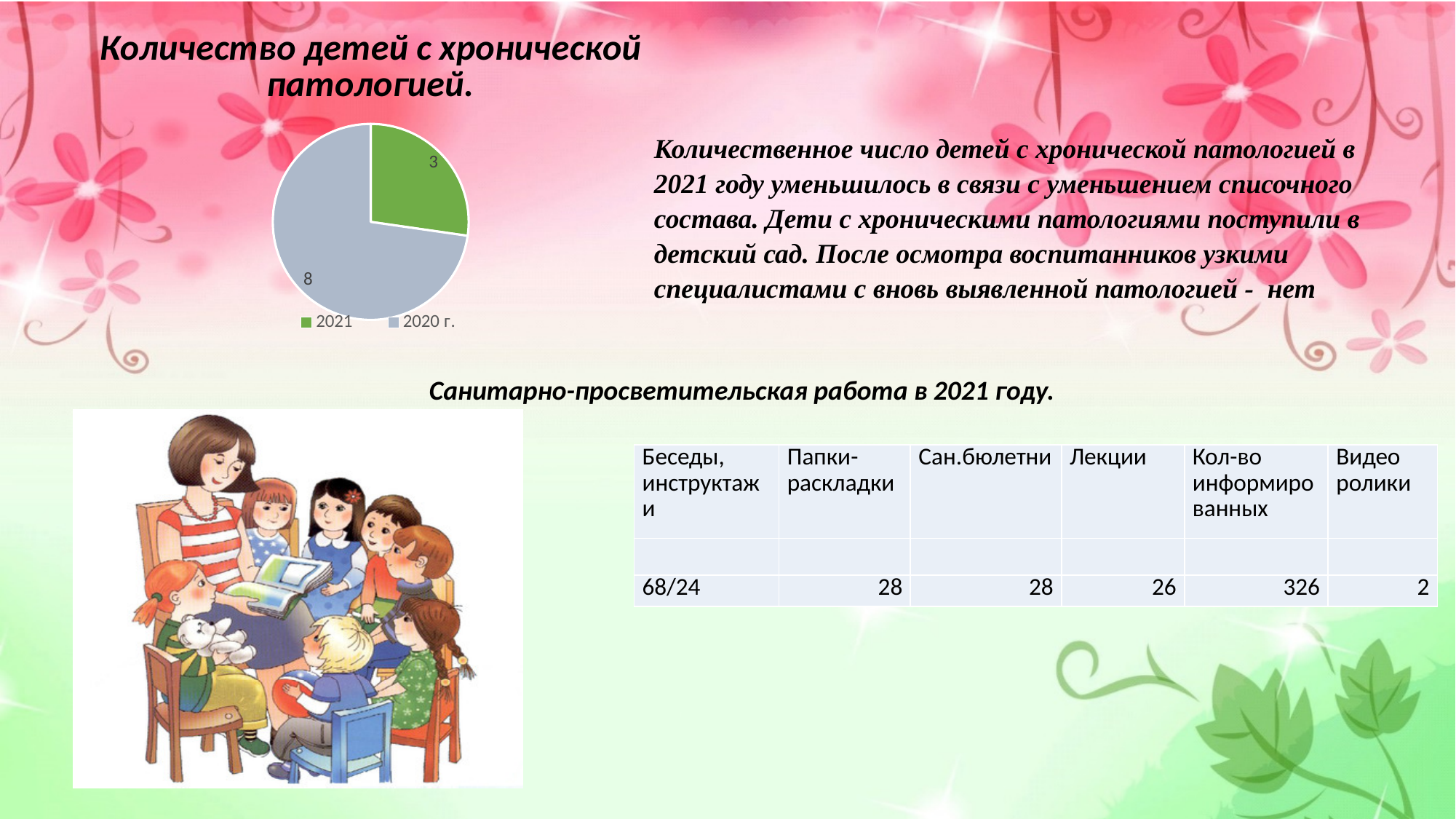
How many slices does the pie chart have? 2 What is the title of the pie chart? Количество детей с хронической патологией. What is the value for 2020 г. in the pie chart? 8 What is the value for 2021 in the pie chart? 3 What is the total of the values shown in the pie chart? 11 Which category has the largest slice in the pie chart? 2020 г. What is the difference between the values for 2020 г. and 2021 in the pie chart? 5 What colour is the 2021 slice in the pie chart? green Which is larger in the pie chart, the value for 2021 or the value for 2020 г.? 2020 г. How many entries does the legend of the pie chart list? 2 What kind of chart is shown on the slide? pie chart Which category has the smallest slice in the pie chart? 2021